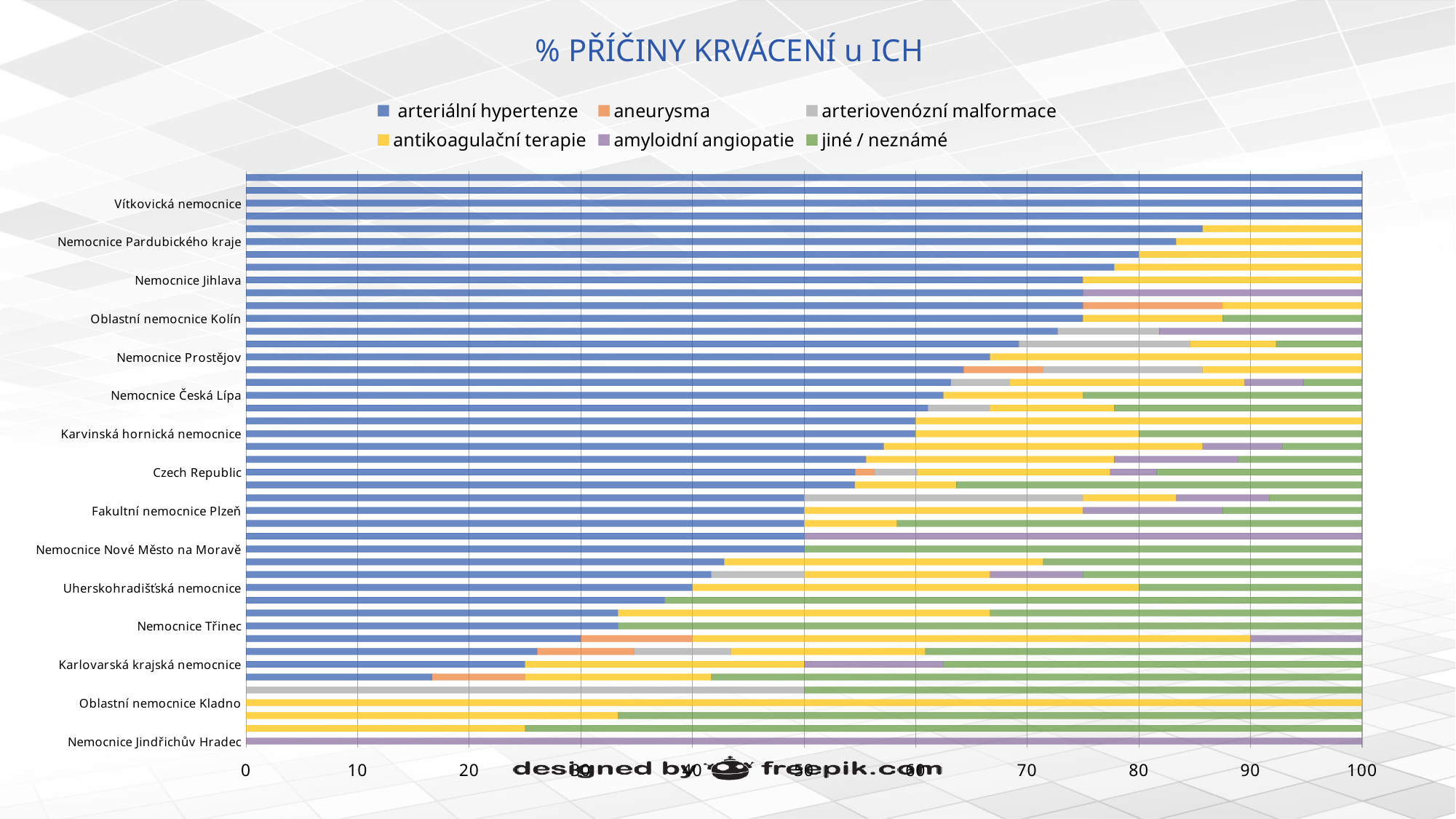
What is the title of the chart? % PŘÍČINY KRVÁCENÍ u ICH Is the arteriální hypertenze value for Karlovarská krajská nemocnice greater or less than 30? less What is the maximum value shown on the horizontal axis? 100 Is the arteriální hypertenze value for Nemocnice Třinec greater or less than 40? less Does the arteriální hypertenze share rise or fall going from the top bar to the bottom bar? fall What kind of chart is shown on the slide? stacked bar chart How many series does the legend list? 6 Is the arteriální hypertenze value for Nemocnice Jihlava greater or less than 70? greater Which series is shown in orange in the legend? aneurysma Which has a larger arteriální hypertenze share, Nemocnice Jihlava or Nemocnice Třinec? Nemocnice Jihlava